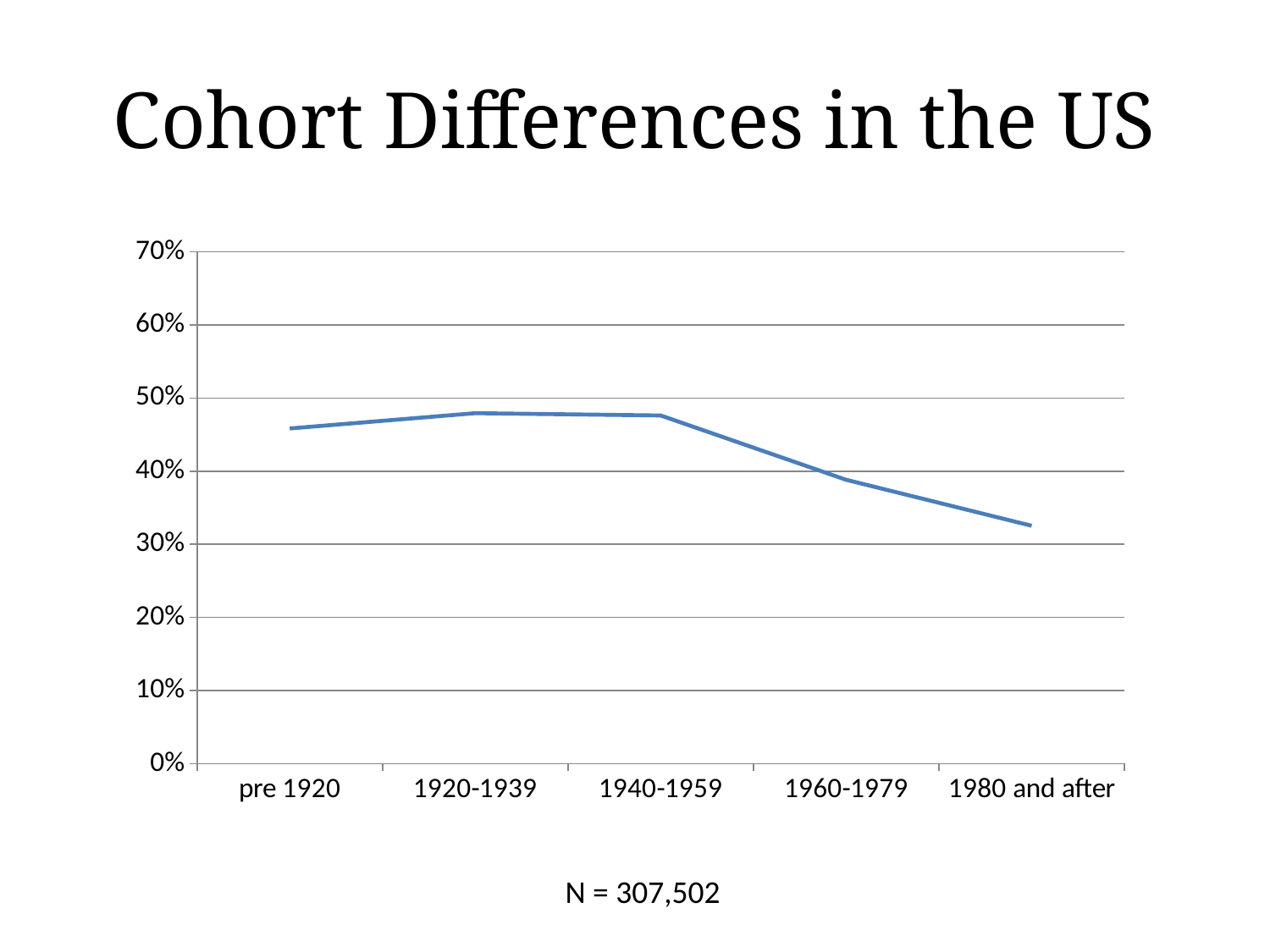
Do the values generally rise or fall from the 1940-1959 cohort to the 1980 and after cohort? fall What sample size (N) is stated below the chart? N = 307,502 Is the value for 1920-1939 greater or less than 50%? less Is the value for 1980 and after greater or less than 40%? less Is the value for pre 1920 greater or less than 40%? greater Which cohort has the lowest value? 1980 and after How many cohort categories are plotted along the x axis? 5 Which is larger, the value for pre 1920 or the value for 1980 and after? pre 1920 What kind of chart is shown on the slide? line chart What is the title of the slide containing the chart? Cohort Differences in the US Which is larger, the value for 1940-1959 or the value for 1960-1979? 1940-1959